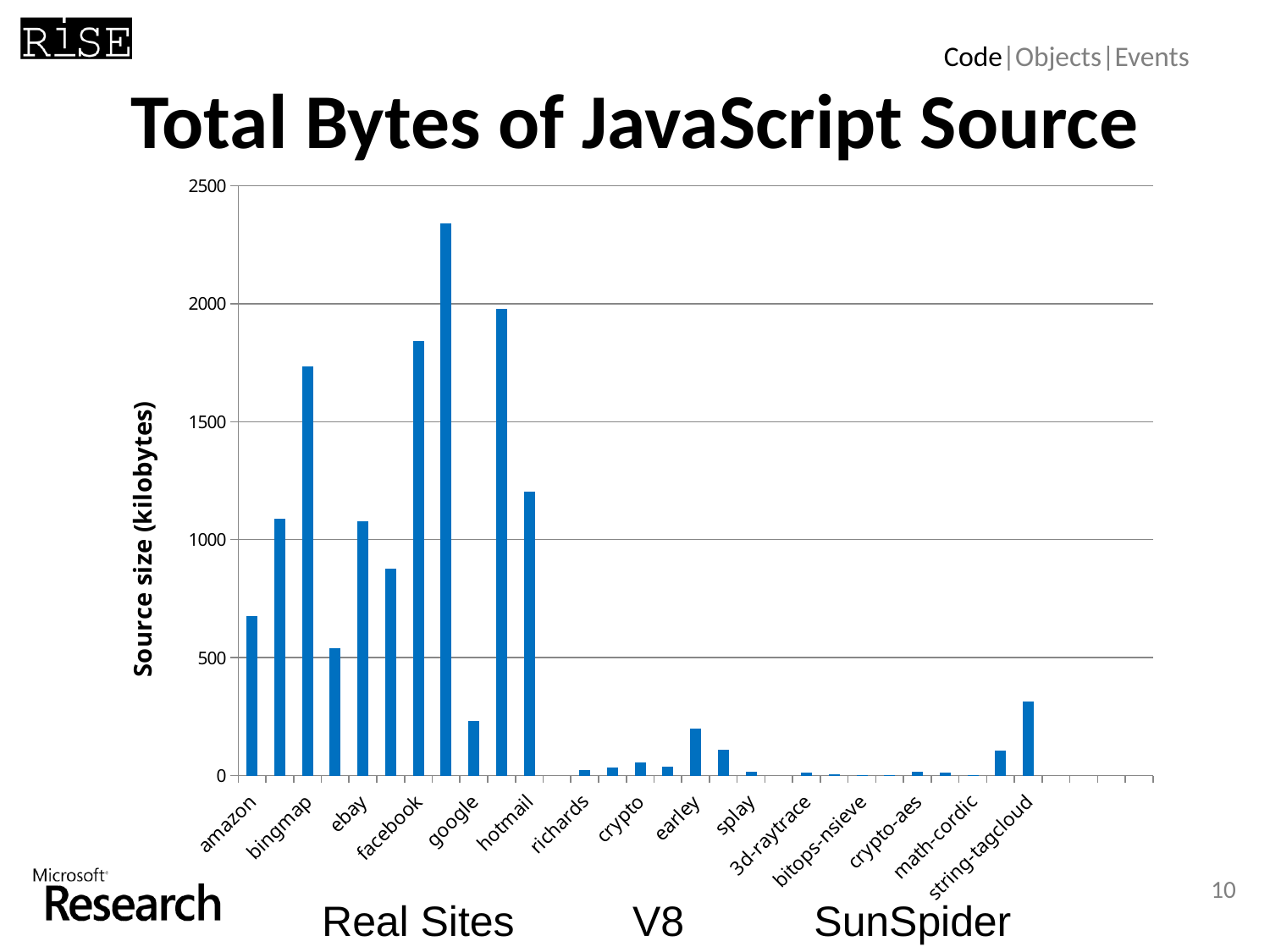
Is the value for string-tagcloud greater or less than 500? less Which has the larger source size, string-tagcloud or richards? string-tagcloud Is the value for hotmail greater or less than 1000? greater What is the label on the vertical axis? Source size (kilobytes) Is the value for bingmap greater or less than 1500? greater Which has the larger source size, facebook or google? facebook What is the title of the chart? Total Bytes of JavaScript Source How many benchmark groups are labeled below the x axis (Real Sites, V8, SunSpider)? 3 What kind of chart is shown on the slide? bar chart Which has the larger source size, hotmail or earley? hotmail